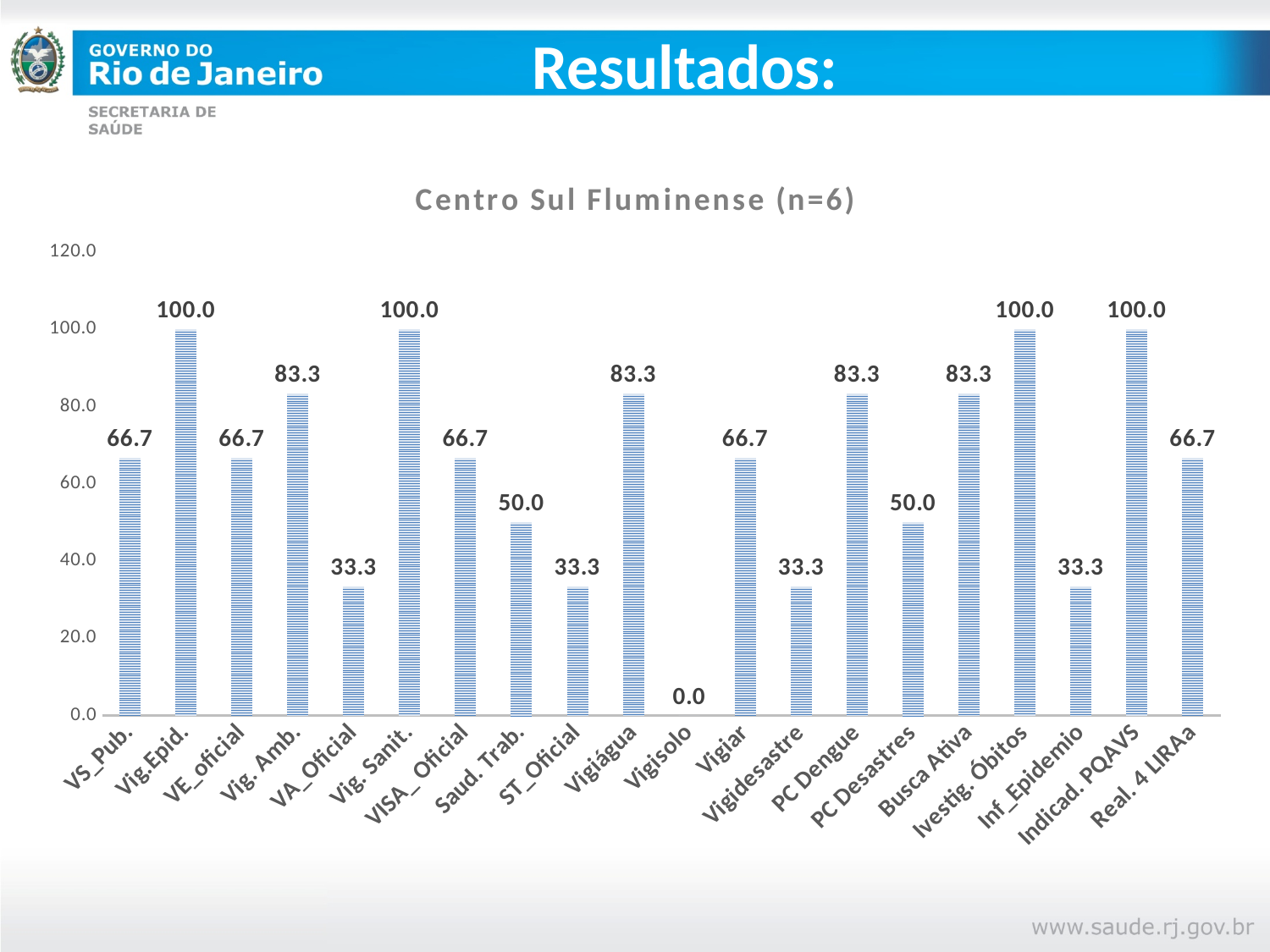
What is the value for Vigisolo? 0.0 Which is larger, the value for PC Dengue or the value for PC Desastres? PC Dengue Is the value for Vigiar greater or less than 60.0? greater What type of chart is shown on the slide? bar chart What is the value for Inf_Epidemio? 33.3 What is the value for Saud. Trab.? 50.0 How many categories are shown on the x axis? 20 What is the value for Vig. Amb.? 83.3 What is the title of the chart? Centro Sul Fluminense (n=6) What is the difference between the values for Vig.Epid. and VA_Oficial? 66.7 How many categories have a value of 100.0? 4 Which category has the lowest value? Vigisolo